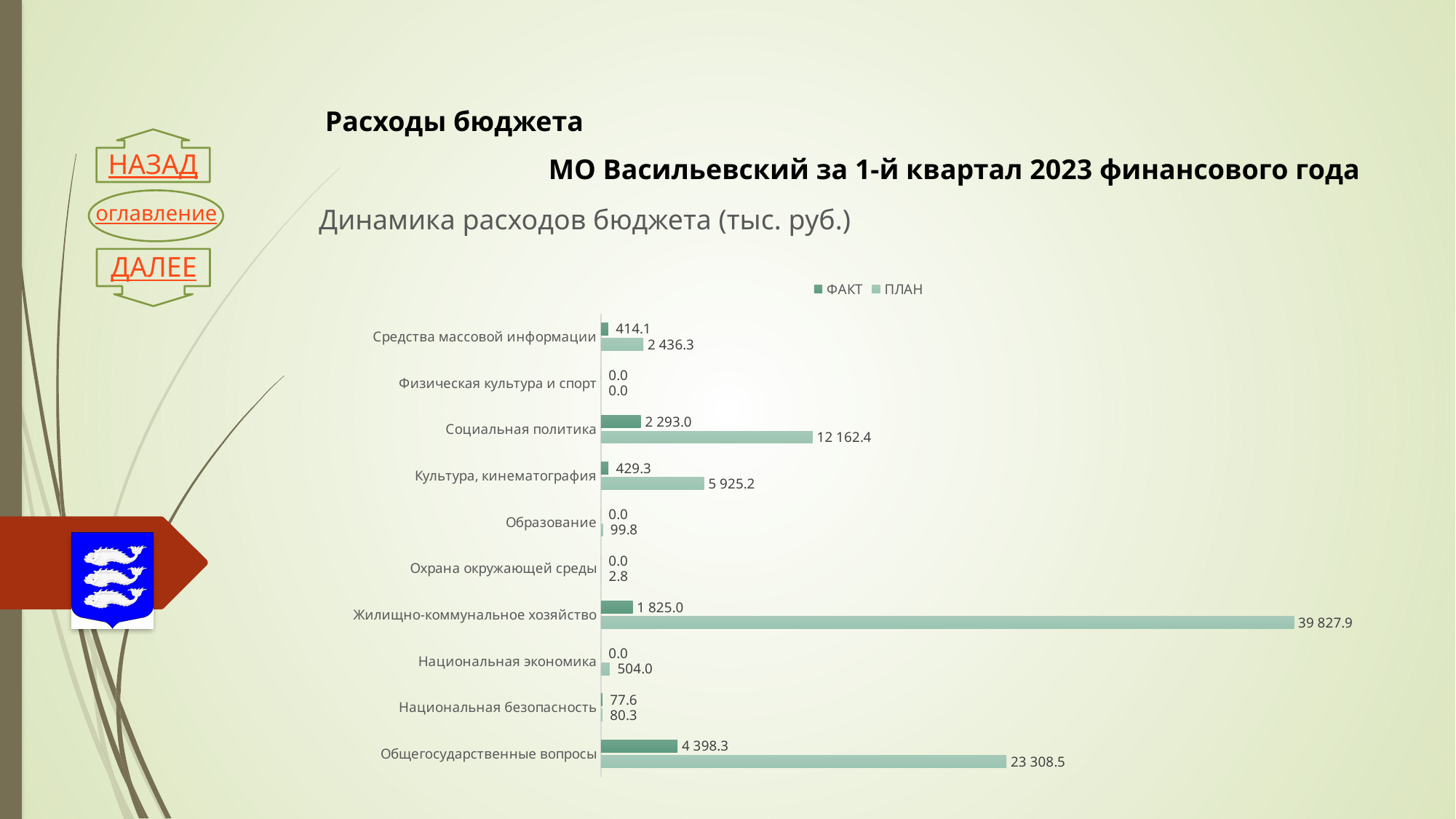
Which is larger for Общегосударственные вопросы: the ФАКТ value or the ПЛАН value? ПЛАН How many categories are shown on the chart? 10 What kind of chart is shown on the slide? Bar chart What is the ФАКТ value for Социальная политика? 2 293.0 What is the ФАКТ value for Национальная безопасность? 77.6 How many series does the legend list? 2 What is the difference between the ПЛАН and ФАКТ values for Социальная политика? 9 869.4 Which category has the highest ПЛАН value? Жилищно-коммунальное хозяйство What is the ПЛАН value for Жилищно-коммунальное хозяйство? 39 827.9 Which category has the lowest ПЛАН value? Физическая культура и спорт What is the ПЛАН value for Культура, кинематография? 5 925.2 Which category has the highest ФАКТ value? Общегосударственные вопросы